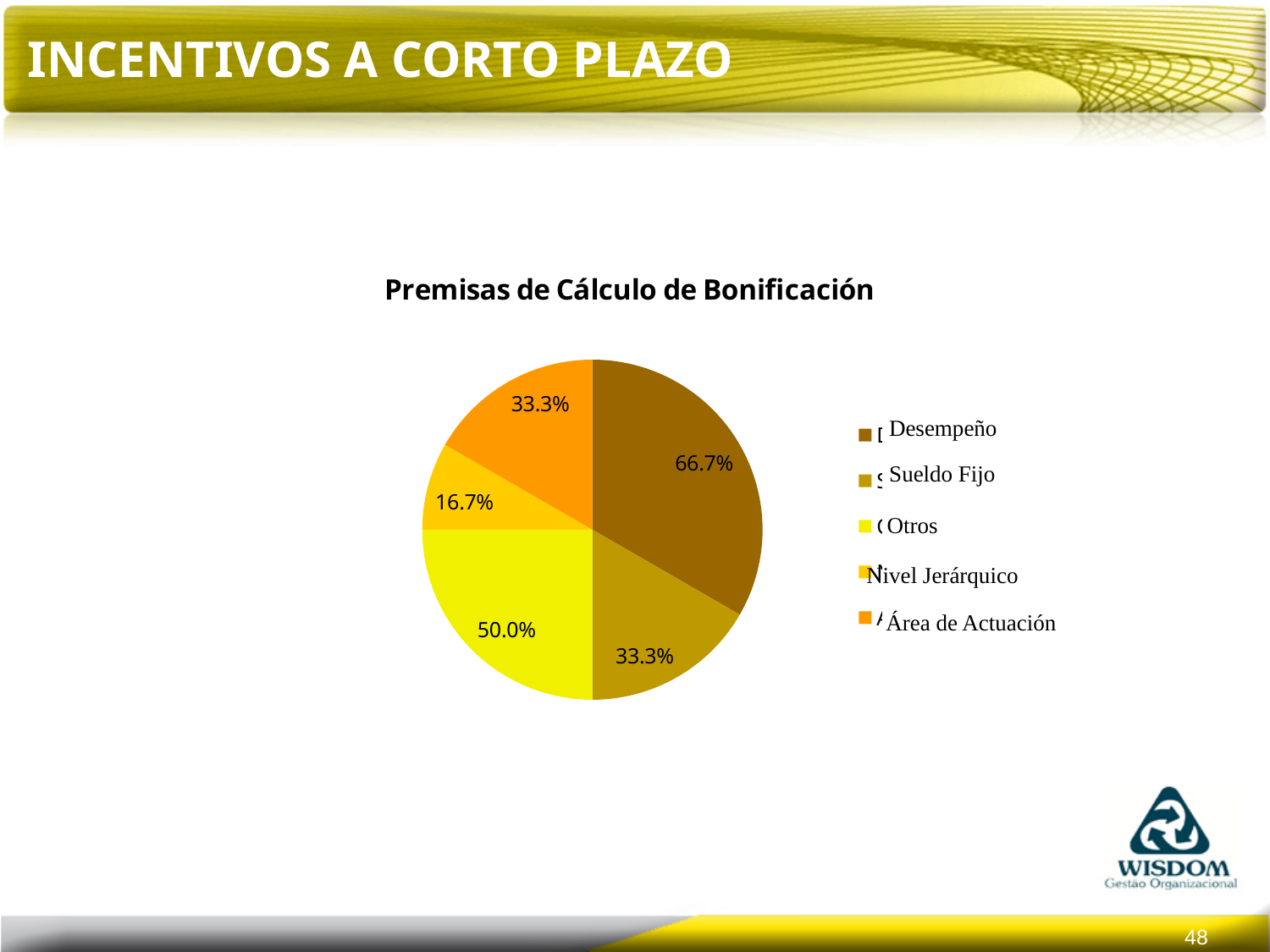
Which is larger, the value for Otros or the value for Sueldo Fijo? Otros Which category has the largest slice of the pie? Desempeño What percentage is shown for Desempeño? 66.7% What is the difference in percentage points between Desempeño and Otros? 16.7 What is the title of the chart? Premisas de Cálculo de Bonificación What percentage is shown for Nivel Jerárquico? 16.7% What type of chart is shown on the slide? Pie chart How many slices does the pie chart have? 5 What percentage is shown for Sueldo Fijo? 33.3% What percentage is shown for Otros? 50.0% Which category has the smallest slice of the pie? Nivel Jerárquico How many entries does the legend list? 5